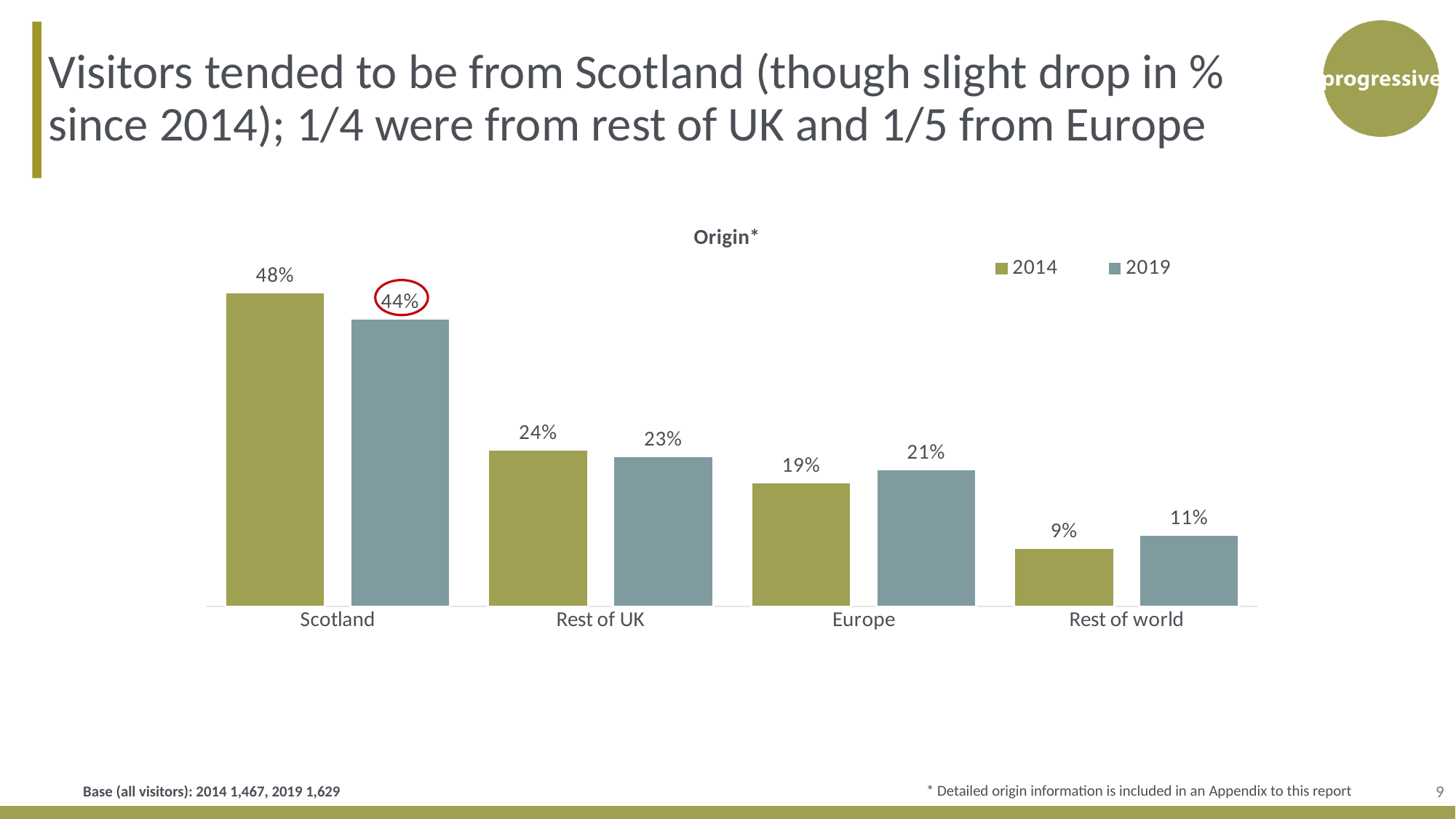
Which series is shown in the olive green colour? 2014 How many categories are shown on the x axis? 4 What is the difference between the 2014 and 2019 values for Scotland? 4% What is the 2014 value for Scotland? 48% Which category has the lowest 2014 value? Rest of world What is the title of the chart? Origin* What is the 2019 value for Europe? 21% What kind of chart is shown on the slide? Bar chart Which category has the highest 2019 value? Scotland How many series does the legend list? 2 Which is larger for Europe, the 2014 value or the 2019 value? 2019 What is the 2014 value for Rest of world? 9%